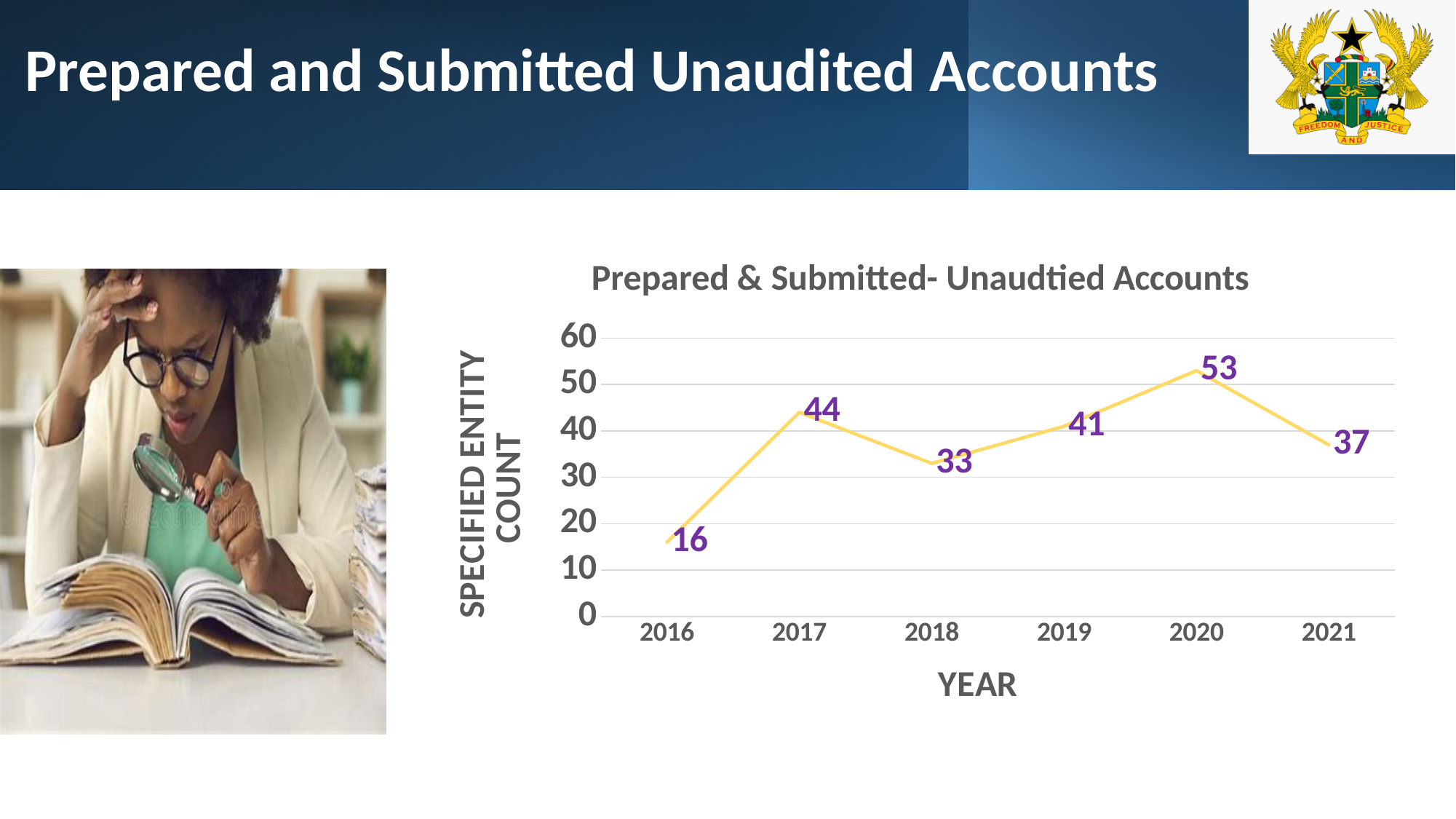
What is the specified entity count for 2020? 53 What is the specified entity count for 2016? 16 What kind of chart is shown on the slide? Line chart What is the specified entity count for 2018? 33 Which year has a larger specified entity count, 2017 or 2019? 2017 Does the specified entity count rise or fall from 2020 to 2021? Fall Which year has the highest specified entity count? 2020 What is the difference between the specified entity count in 2017 and in 2016? 28 What is the difference between the specified entity count in 2020 and in 2021? 16 What is the title of the chart? Prepared & Submitted- Unaudtied Accounts Which year has the lowest specified entity count? 2016 How many years are plotted on the chart? 6